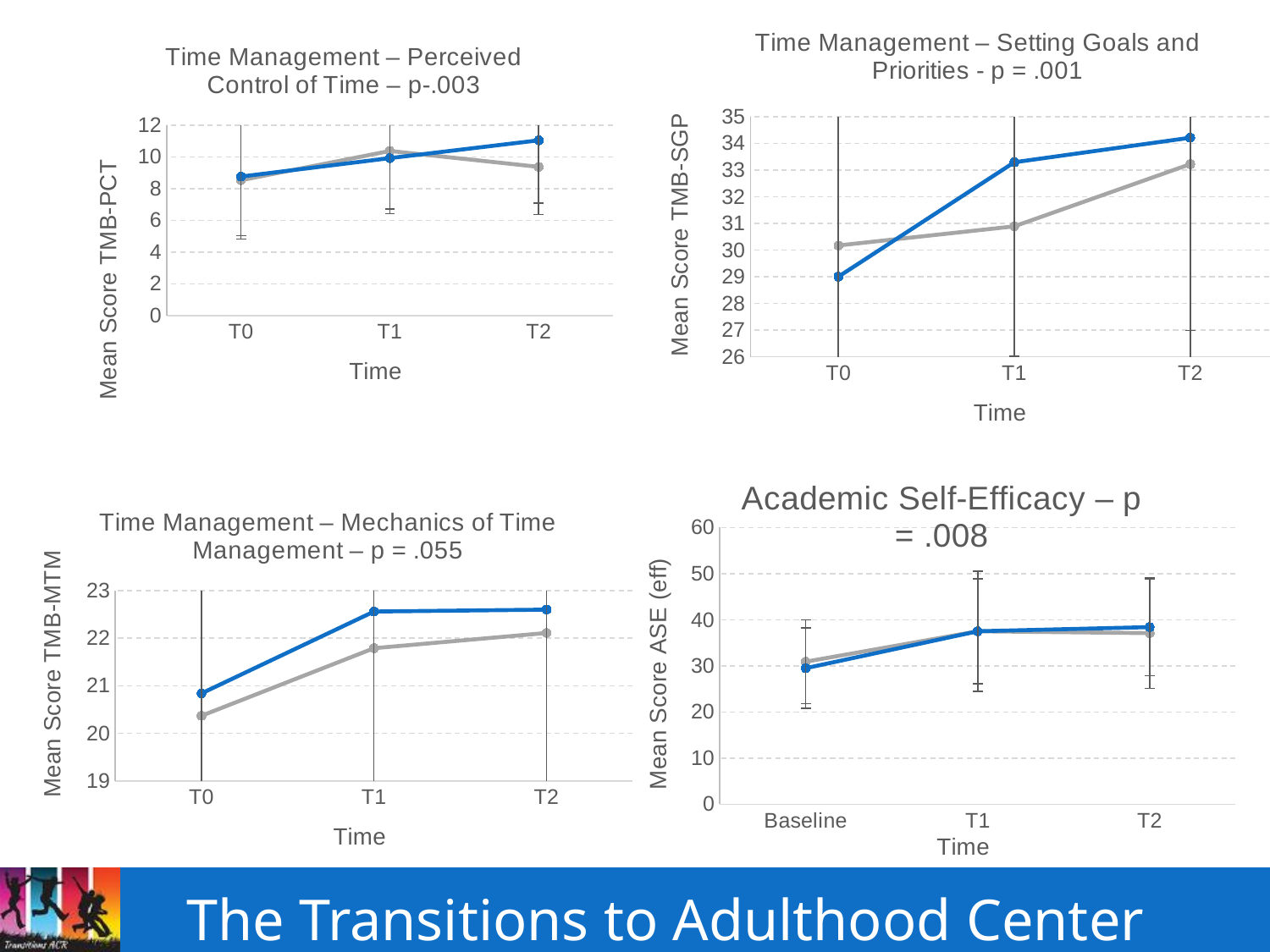
In the 'Time Management – Setting Goals and Priorities' chart, does the blue line rise or fall from T0 to T2? rise In the 'Academic Self-Efficacy' chart, what are the labels on the x axis? Baseline, T1, T2 In the 'Time Management – Mechanics of Time Management' chart, is the grey line's value at T0 greater or less than 21? less In the 'Time Management – Mechanics of Time Management' chart, does the grey line rise or fall from T0 to T1? rise In the 'Time Management – Perceived Control of Time' chart, how many time points are shown on the x axis? 3 What kind of chart is the 'Time Management – Setting Goals and Priorities' chart? line chart In the 'Time Management – Setting Goals and Priorities' chart, at T1 which line is higher, the blue line or the grey line? the blue line What is the y-axis label of the 'Time Management – Mechanics of Time Management' chart? Mean Score TMB-MTM In the 'Academic Self-Efficacy' chart, is the blue line's value at T2 greater or less than 40? less In the 'Time Management – Mechanics of Time Management' chart, at T1 which line is higher, the blue line or the grey line? the blue line In the 'Time Management – Setting Goals and Priorities' chart, is the blue line's value at T1 greater or less than 33? greater